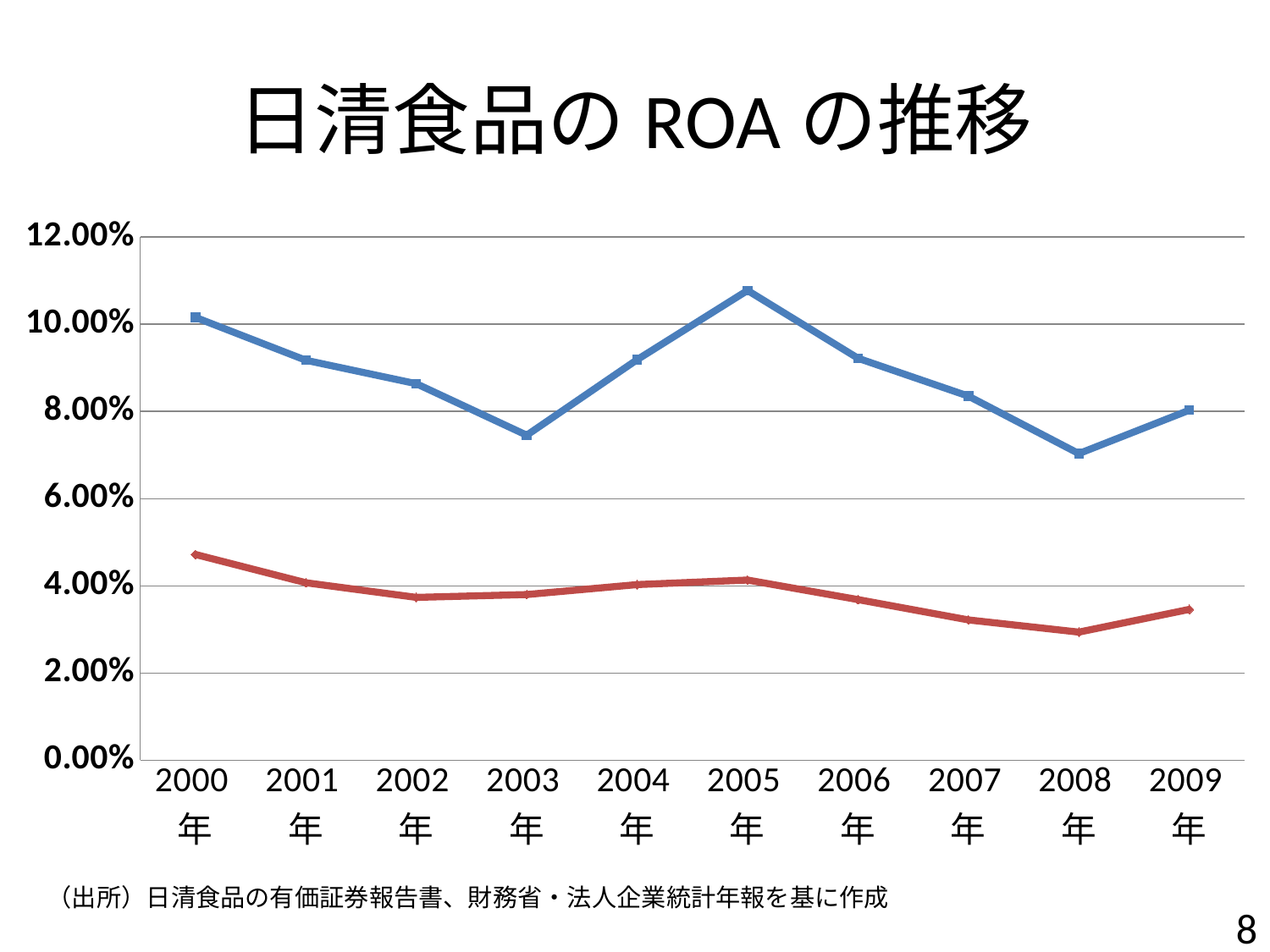
How many years are plotted along the x axis? 10 Is the value of the red line in 2007年 greater or less than 4.00%? less Is the value of the blue line in 2003年 greater or less than 8.00%? less What kind of chart is shown on the slide? line chart In which year does the red line reach its highest value? 2000年 Does the blue line rise or fall from 2005年 to 2008年? fall In which year does the blue line reach its highest value? 2005年 In which year does the blue line reach its lowest value? 2008年 In 2005年, which line has the larger value, the blue line or the red line? the blue line How many lines are plotted on the chart? 2 Is the value of the blue line in 2005年 greater or less than 10.00%? greater What is the title of the chart? 日清食品のROAの推移